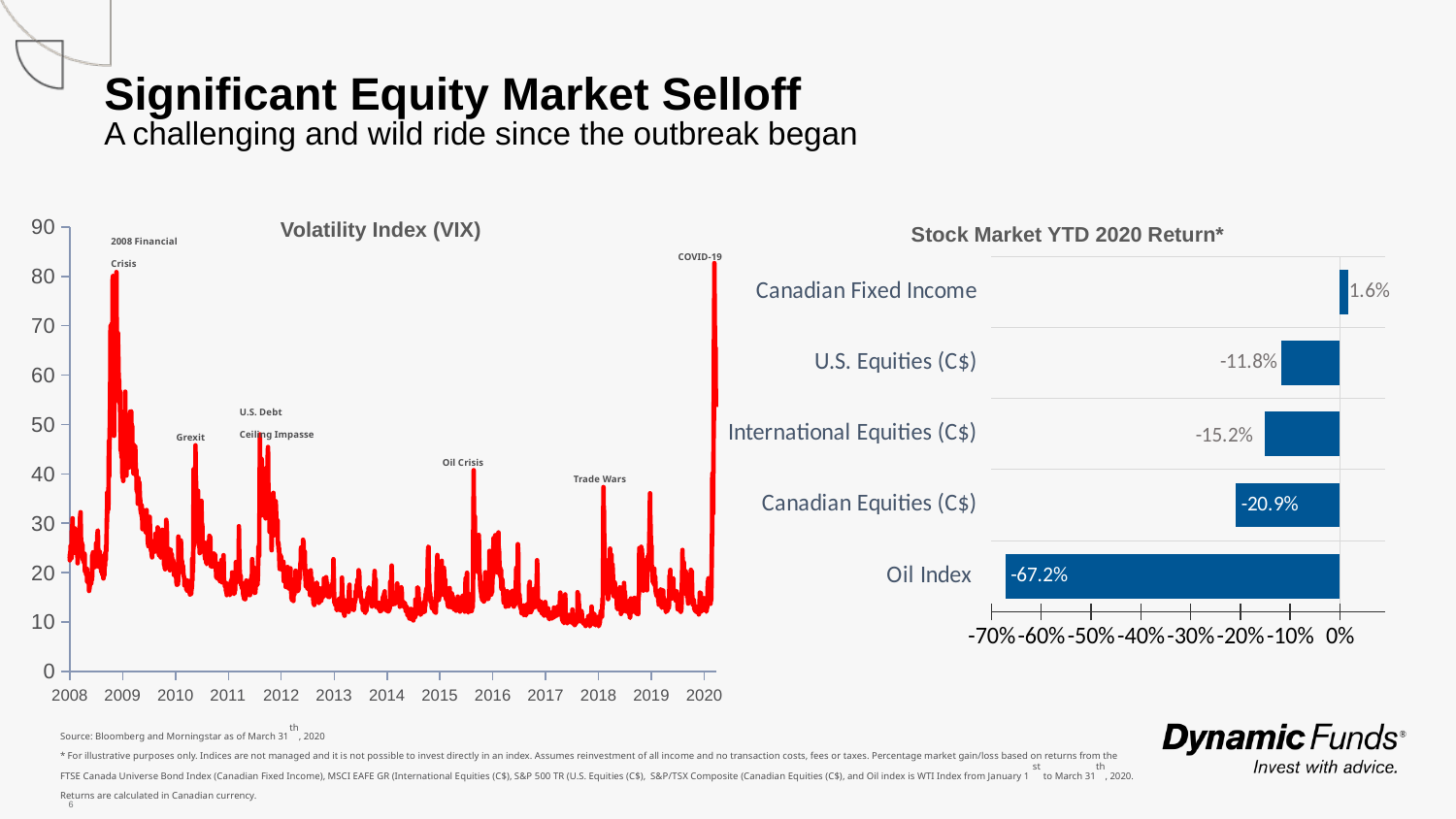
In the Stock Market YTD 2020 Return* chart, which category has the lowest return? Oil Index In the Volatility Index (VIX) chart, is the peak labelled COVID-19 greater or less than 70? greater In the Stock Market YTD 2020 Return* chart, which has the larger (less negative) return, International Equities (C$) or Canadian Equities (C$)? International Equities (C$) In the Stock Market YTD 2020 Return* chart, which category has the highest return? Canadian Fixed Income In the Stock Market YTD 2020 Return* chart, what is the value for the Oil Index? -67.2% In the Volatility Index (VIX) chart, is the peak labelled Oil Crisis greater or less than 30? greater What kind of chart is the Stock Market YTD 2020 Return* chart? Bar chart In the Stock Market YTD 2020 Return* chart, what is the value for U.S. Equities (C$)? -11.8% What kind of chart is the Volatility Index (VIX) chart? Line chart In the Stock Market YTD 2020 Return* chart, what is the value for Canadian Fixed Income? 1.6% How many categories are shown in the Stock Market YTD 2020 Return* chart? 5 In the Stock Market YTD 2020 Return* chart, what is the difference between the returns for U.S. Equities (C$) and Canadian Equities (C$)? 9.1 percentage points